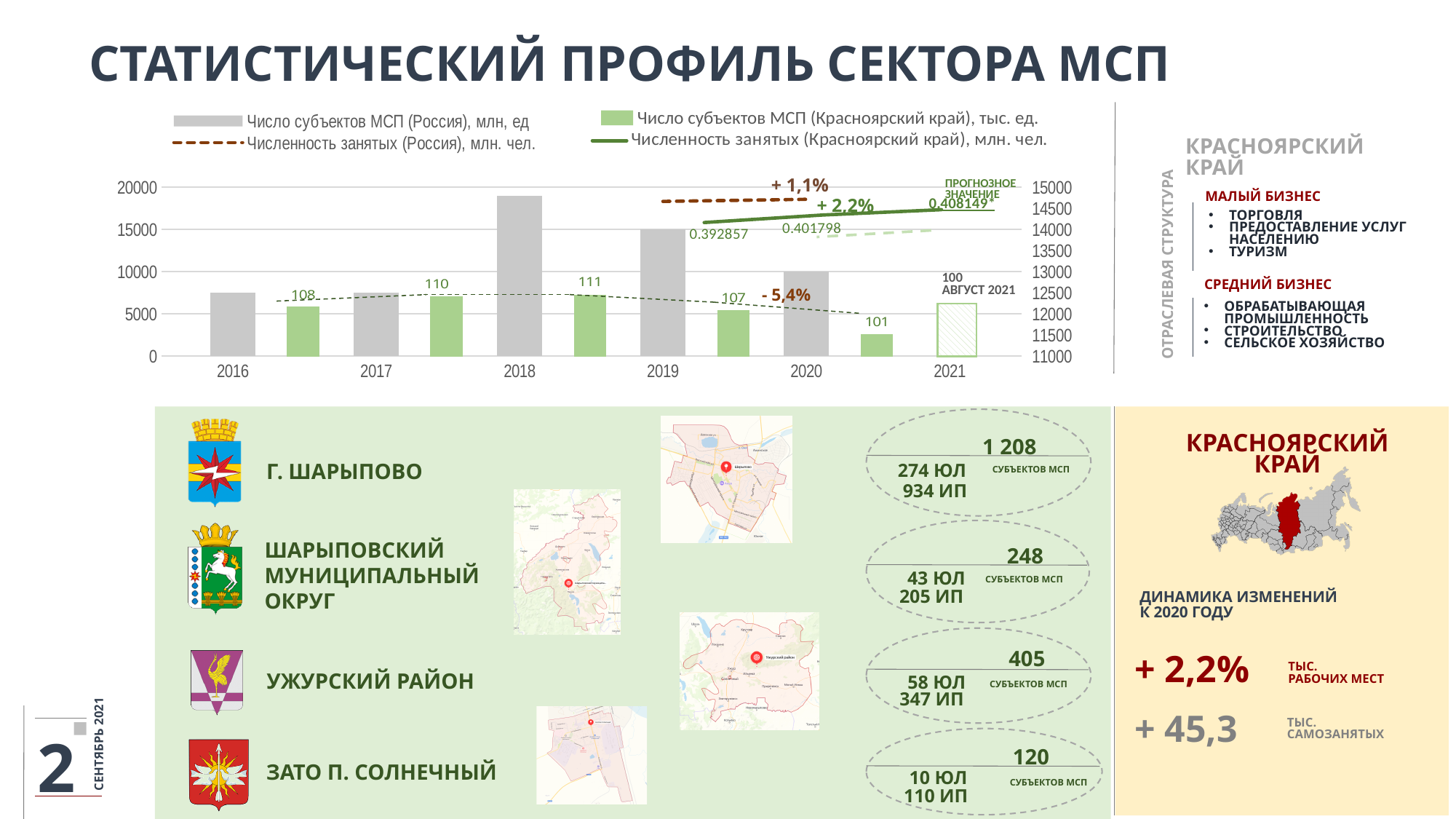
Is the 2018 value for the number of MSP subjects in Russia (gray bar) greater or less than 15000 on the left axis? greater In which year is the number of MSP subjects in Krasnoyarsk Krai (green bars) highest? 2018 Does the number of MSP subjects in Krasnoyarsk Krai rise or fall from 2018 to 2021? fall Which year has the larger number of MSP subjects in Krasnoyarsk Krai, 2017 or 2019? 2017 What is the number of MSP subjects in Krasnoyarsk Krai (thousand units) for 2020? 101 What is the number of employed in Krasnoyarsk Krai (mln people) shown for 2019? 0.392857 In which year is the number of MSP subjects in Krasnoyarsk Krai (green bars) lowest? 2021 What is the number of MSP subjects in Krasnoyarsk Krai (thousand units) for 2018? 111 By how much did the number of MSP subjects in Krasnoyarsk Krai (thousand units) fall from 2018 to 2020? 10 What is the forecast value (прогнозное значение) for the number of employed in Krasnoyarsk Krai in 2021? 0.408149* How many years are shown on the x axis of the chart? 6 How many series does the chart legend list? 4